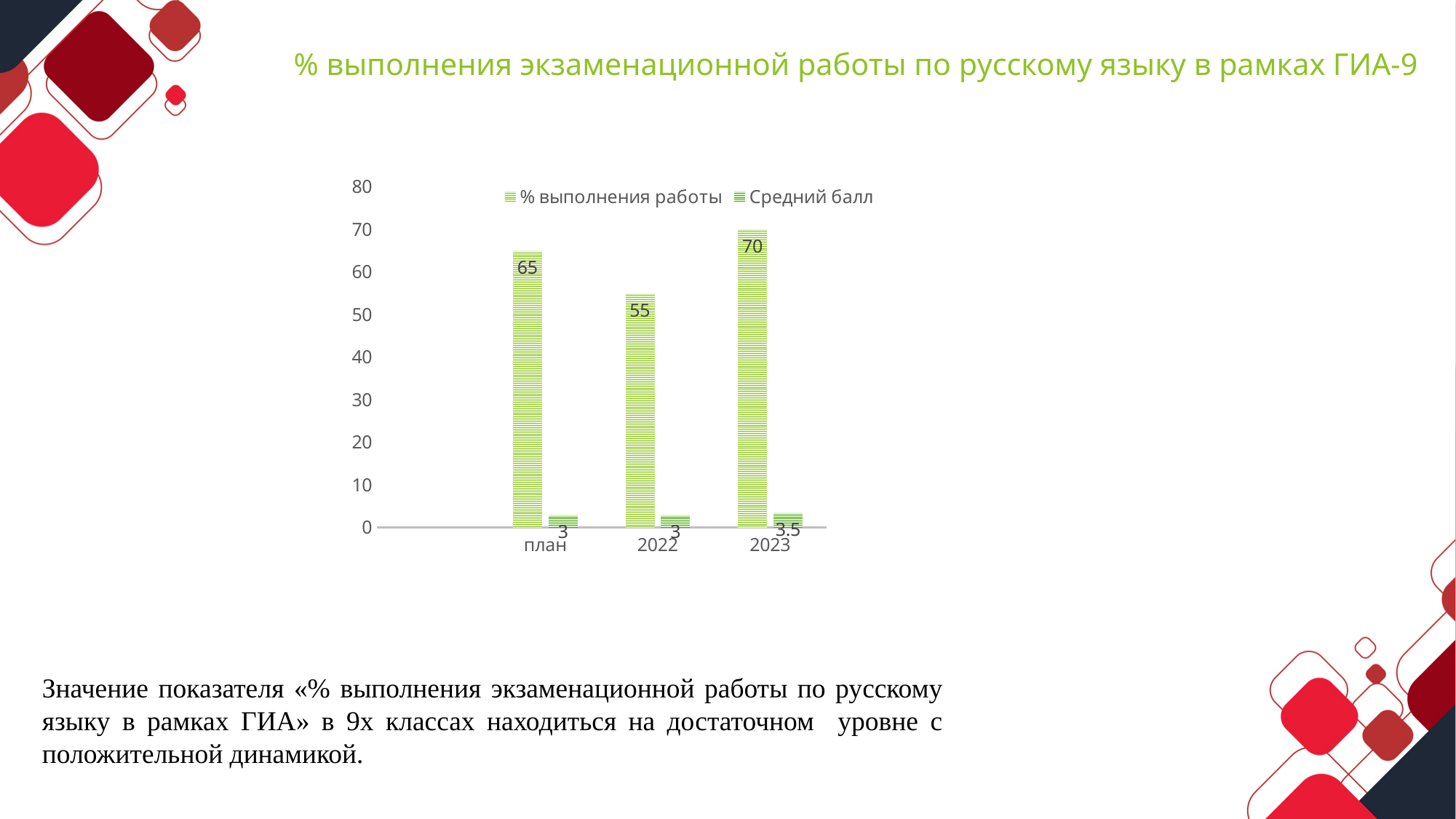
What is the difference between the "% выполнения работы" values for 2023 and 2022? 15 Which category has the lowest value for "% выполнения работы"? 2022 How many categories are shown on the x axis? 3 What is the value of "% выполнения работы" for план? 65 Which is larger: the "% выполнения работы" value for план or for 2022? план What kind of chart is shown on the slide? bar chart What is the value of "Средний балл" for 2023? 3.5 What is the value of "Средний балл" for 2022? 3 Which category has the highest value for "% выполнения работы"? 2023 Is the "% выполнения работы" value for 2022 greater or less than 60? less How many series does the legend list? 2 What is the value of "% выполнения работы" for 2023? 70